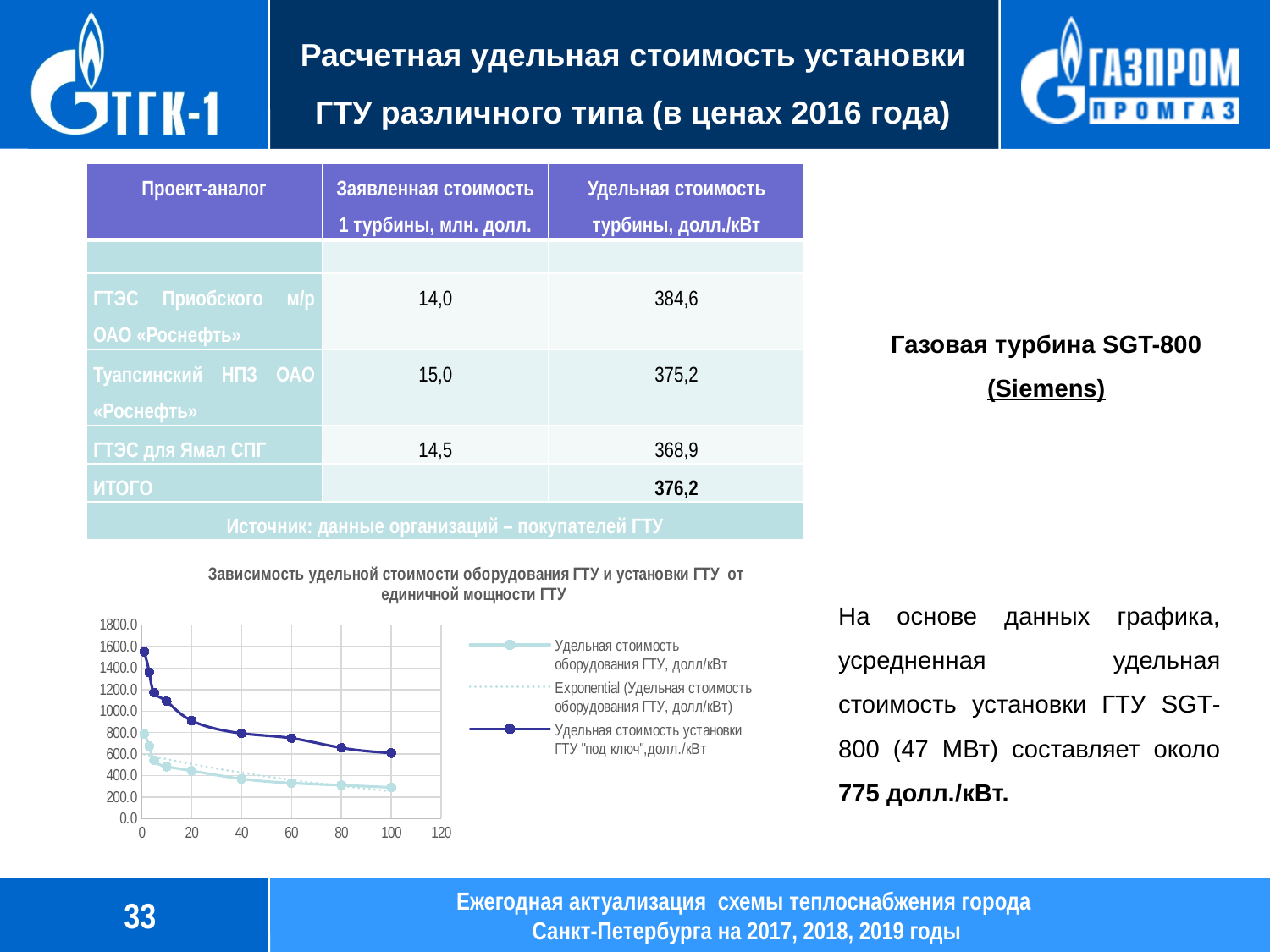
At x = 80, which series has the larger value: "Удельная стоимость установки ГТУ "под ключ",долл./кВт" or "Удельная стоимость оборудования ГТУ, долл/кВт"? Удельная стоимость установки ГТУ "под ключ",долл./кВт Is the value of the series "Удельная стоимость установки ГТУ "под ключ",долл./кВт" at x = 20 greater or less than 800? greater Which series lies higher on the chart across the whole x-axis range? Удельная стоимость установки ГТУ "под ключ",долл./кВт How many entries does the chart legend list? 3 Which legend entry is drawn as a dotted line? Exponential (Удельная стоимость оборудования ГТУ, долл/кВт) What kind of chart is shown on the slide? line chart Is the value of the series "Удельная стоимость установки ГТУ "под ключ",долл./кВт" at x = 60 greater or less than 600? greater Is the value of the series "Удельная стоимость оборудования ГТУ, долл/кВт" at x = 20 greater or less than 600? less Do the values of the series "Удельная стоимость установки ГТУ "под ключ",долл./кВт" rise or fall as the x-axis value increases? fall Do the values of the series "Удельная стоимость оборудования ГТУ, долл/кВт" rise or fall along the x axis? fall What is the title of the chart? Зависимость удельной стоимости оборудования ГТУ и установки ГТУ от единичной мощности ГТУ